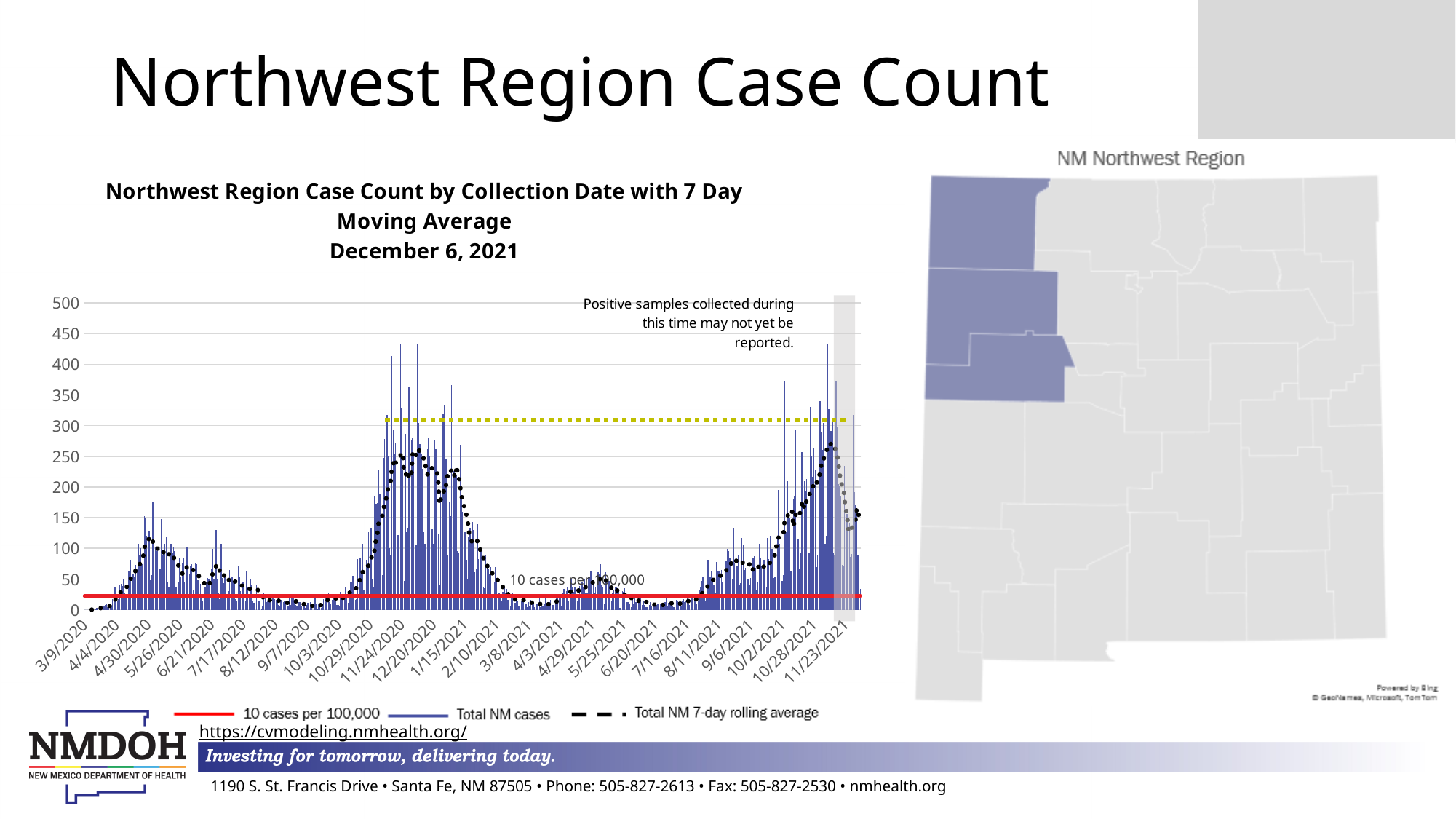
What is the title of the chart? Northwest Region Case Count by Collection Date with 7 Day Moving Average December 6, 2021 Does the 7-day rolling average rise or fall between 8/11/2021 and 10/28/2021? rise Is the peak of the 7-day rolling average in late November 2020 greater or less than 200? greater How many series does the chart's legend list? 3 What is the highest value shown on the chart's y axis? 500 Is the highest daily case bar around 11/24/2020 greater or less than 400? greater Does the 7-day rolling average rise or fall between 1/15/2021 and 3/8/2021? fall How many date labels are shown along the chart's x axis? 25 Which peak of the 7-day rolling average is higher: the one around 4/30/2020 or the one around 11/24/2020? 11/24/2020 What does the red horizontal line in the chart represent, according to the legend? 10 cases per 100,000 What kind of chart is shown on the slide? Bar chart Is the 7-day rolling average around 7/16/2021 greater or less than 50? less